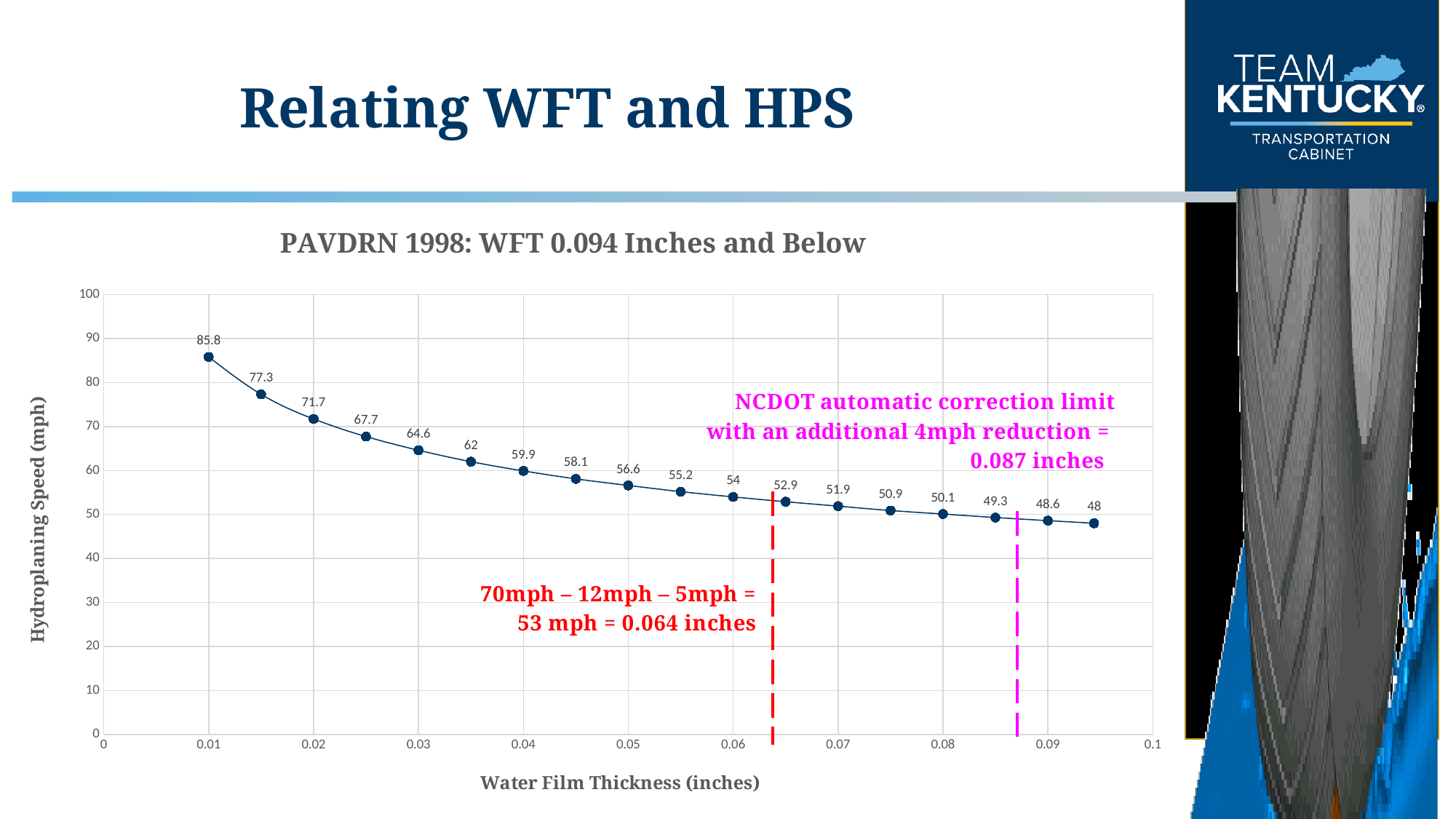
How many data points are plotted on the chart? 18 What is the title of the chart? PAVDRN 1998: WFT 0.094 Inches and Below What is the hydroplaning speed at a water film thickness of 0.03 inches? 64.6 What is the hydroplaning speed at a water film thickness of 0.01 inches? 85.8 What is the highest hydroplaning speed value plotted on the chart? 85.8 What is the lowest hydroplaning speed value plotted on the chart? 48 What is the hydroplaning speed at a water film thickness of 0.09 inches? 48.6 What type of chart is shown on the slide? line chart What is the difference between the hydroplaning speed at 0.01 inches and at 0.02 inches? 14.1 Which has a higher hydroplaning speed: a water film thickness of 0.04 inches or 0.07 inches? 0.04 inches What is the hydroplaning speed at a water film thickness of 0.06 inches? 54 Do the hydroplaning speed values rise or fall as water film thickness increases? fall